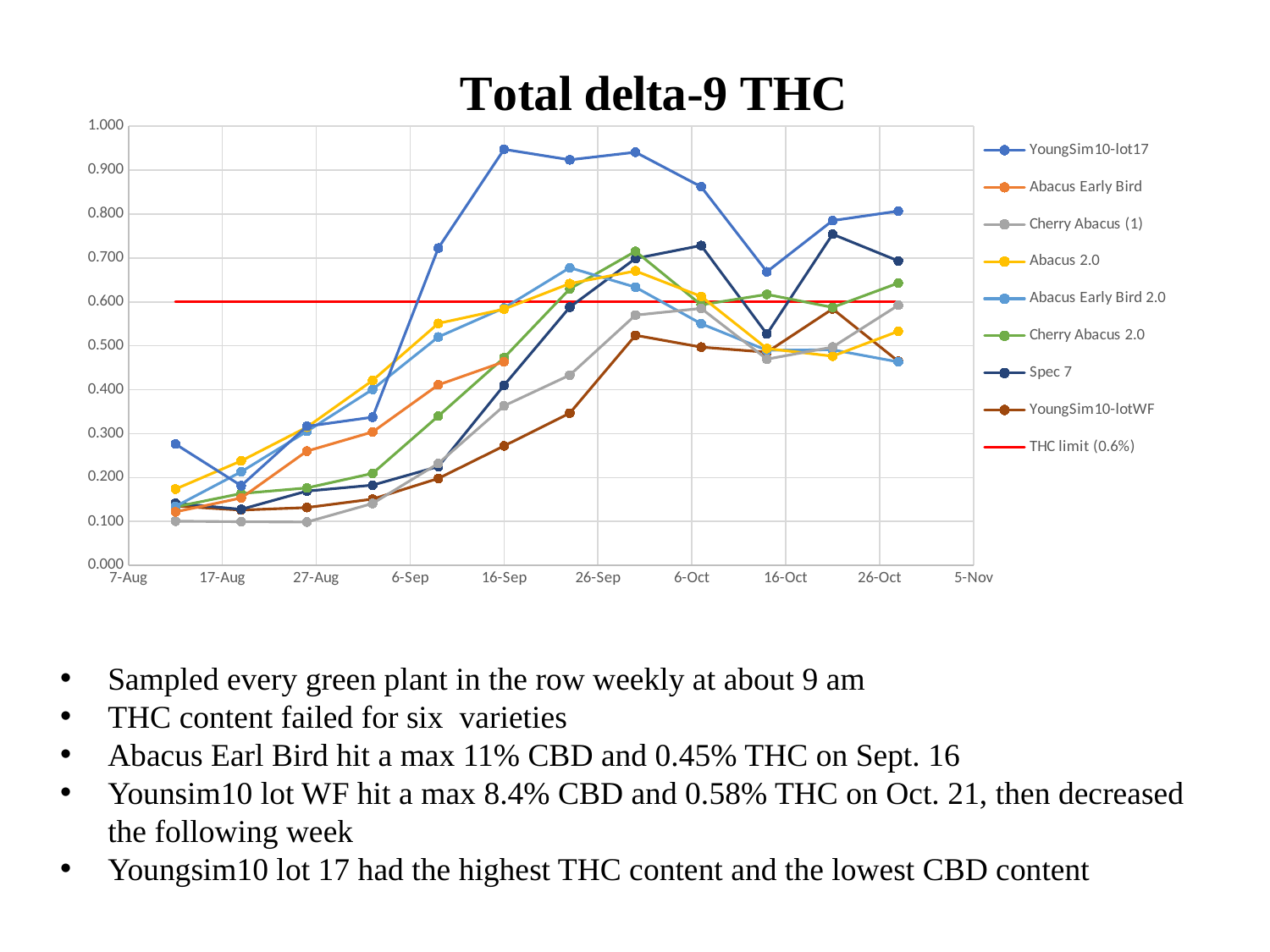
Is the value for Abacus Early Bird 2.0 at its last point (late October) greater or less than 0.500? less How many entries does the chart legend list? 9 Which series reaches the highest value on the chart? YoungSim10-lot17 Is the value for YoungSim10-lot17 at 16-Sep greater or less than 0.900? greater Does the YoungSim10-lot17 series rise or fall between 6-Sep and 16-Sep? rise According to the legend, what is the THC limit shown by the red line? 0.6% What is the title of the chart? Total delta-9 THC What kind of chart is shown on the slide? line chart At 16-Sep, which is larger: YoungSim10-lot17 or Spec 7? YoungSim10-lot17 Is the value for Spec 7 at 6-Oct greater or less than 0.700? greater